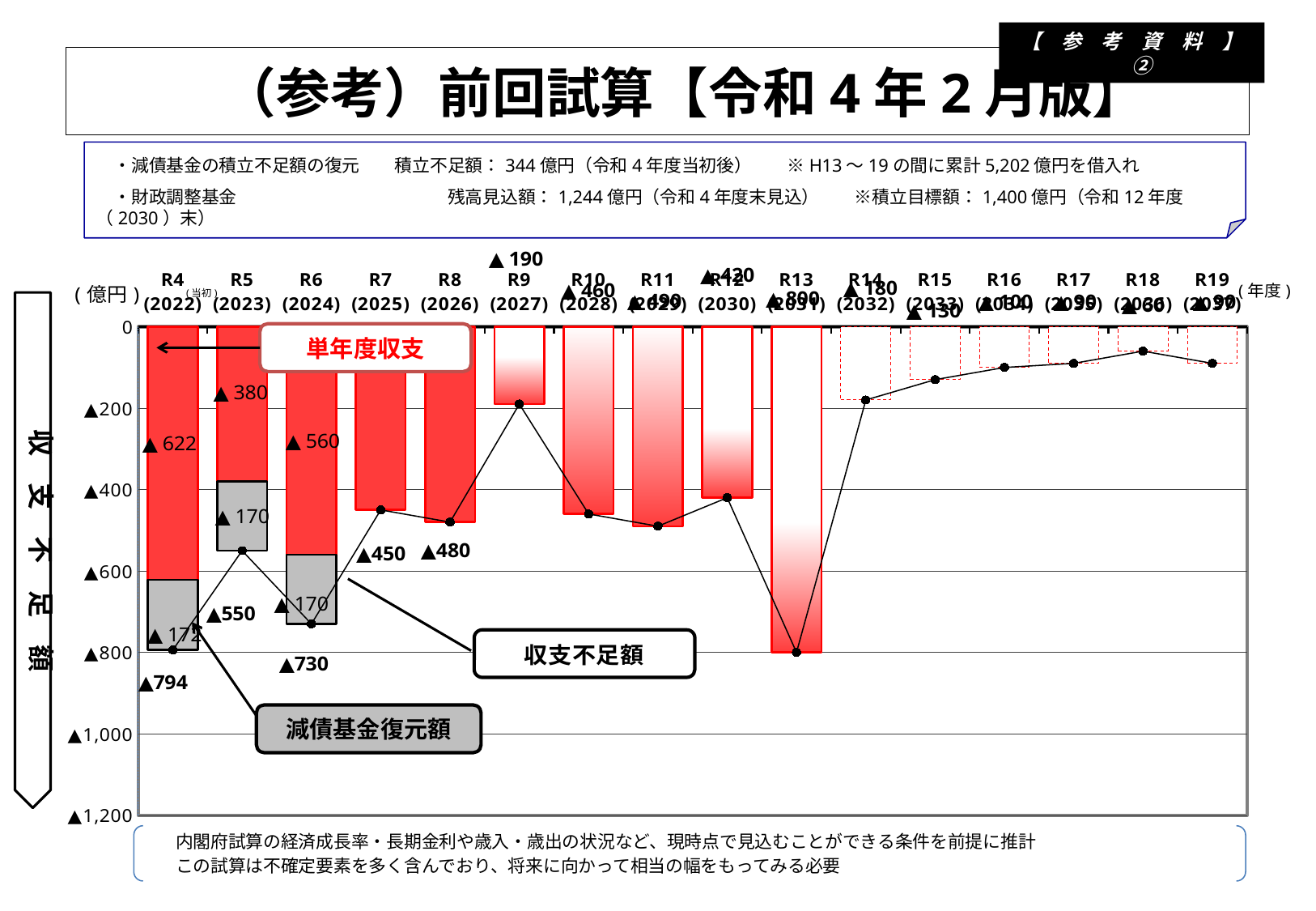
What is the 収支不足額 value for R9 (2027)? ▲190 What is the 収支不足額 value for R13 (2031)? ▲800 How many fiscal years (categories) are shown along the x axis of the chart? 16 What is the difference between the 収支不足額 for R4 (2022) and R5 (2023)? 244 What does the gray bar in the chart represent, according to the label? 減債基金復元額 What is the 収支不足額 (line value) for R4 (2022)? ▲794 What kind of chart is shown on the slide? Combined bar and line chart What is the 減債基金復元額 (gray bar) value for R6 (2024)? ▲170 Which year has the larger 収支不足額, R6 (2024) or R7 (2025)? R6 (2024) Is the 収支不足額 for R14 (2032) greater or less than ▲200 in magnitude? less What is the total of the stacked bar (red plus gray) for R4 (2022)? ▲794 What is the 単年度収支 (red bar) value for R5 (2023)? ▲380